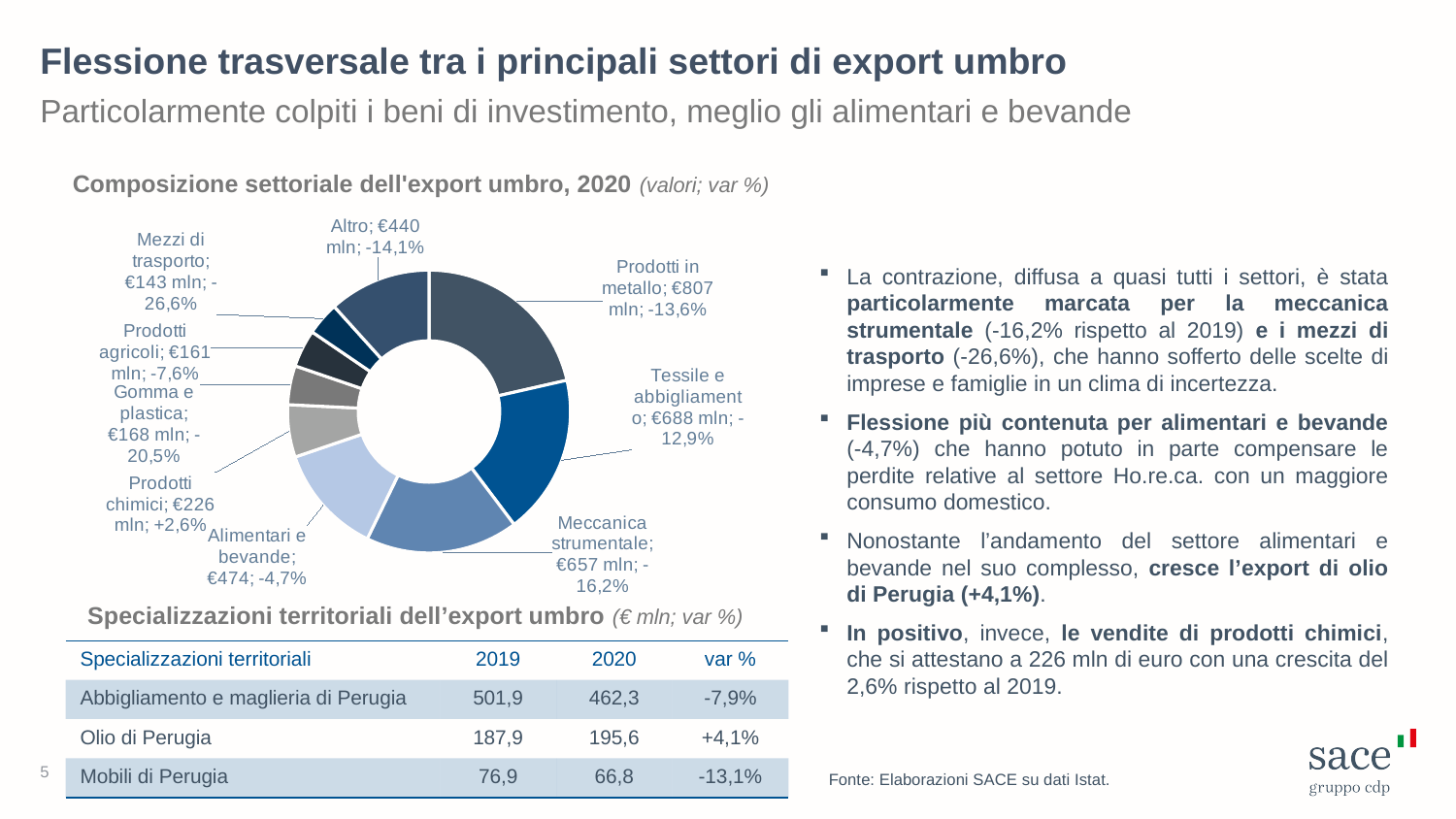
What kind of chart is used to show the 'Composizione settoriale dell'export umbro, 2020'? Doughnut (pie) chart In the 'Composizione settoriale dell'export umbro, 2020' chart, what is the percentage change shown for Mezzi di trasporto? -26,6% What is the title of the doughnut chart on the slide? Composizione settoriale dell'export umbro, 2020 How many sectors are shown in the 'Composizione settoriale dell'export umbro, 2020' chart? 9 In the 'Composizione settoriale dell'export umbro, 2020' chart, what is the export value for Prodotti in metallo? €807 mln Which sector has the largest export value in the 'Composizione settoriale dell'export umbro, 2020' chart? Prodotti in metallo In the 'Composizione settoriale dell'export umbro, 2020' chart, which sector is the only one with a positive percentage change? Prodotti chimici In the 'Composizione settoriale dell'export umbro, 2020' chart, what is the percentage change shown for Meccanica strumentale? -16,2% In the 'Composizione settoriale dell'export umbro, 2020' chart, which has a larger export value: Gomma e plastica or Prodotti chimici? Prodotti chimici In the 'Composizione settoriale dell'export umbro, 2020' chart, what is the export value for Alimentari e bevande? €474 Which sector has the smallest export value in the 'Composizione settoriale dell'export umbro, 2020' chart? Mezzi di trasporto In the 'Composizione settoriale dell'export umbro, 2020' chart, what is the difference in export value between Prodotti in metallo and Tessile e abbigliamento? €119 mln